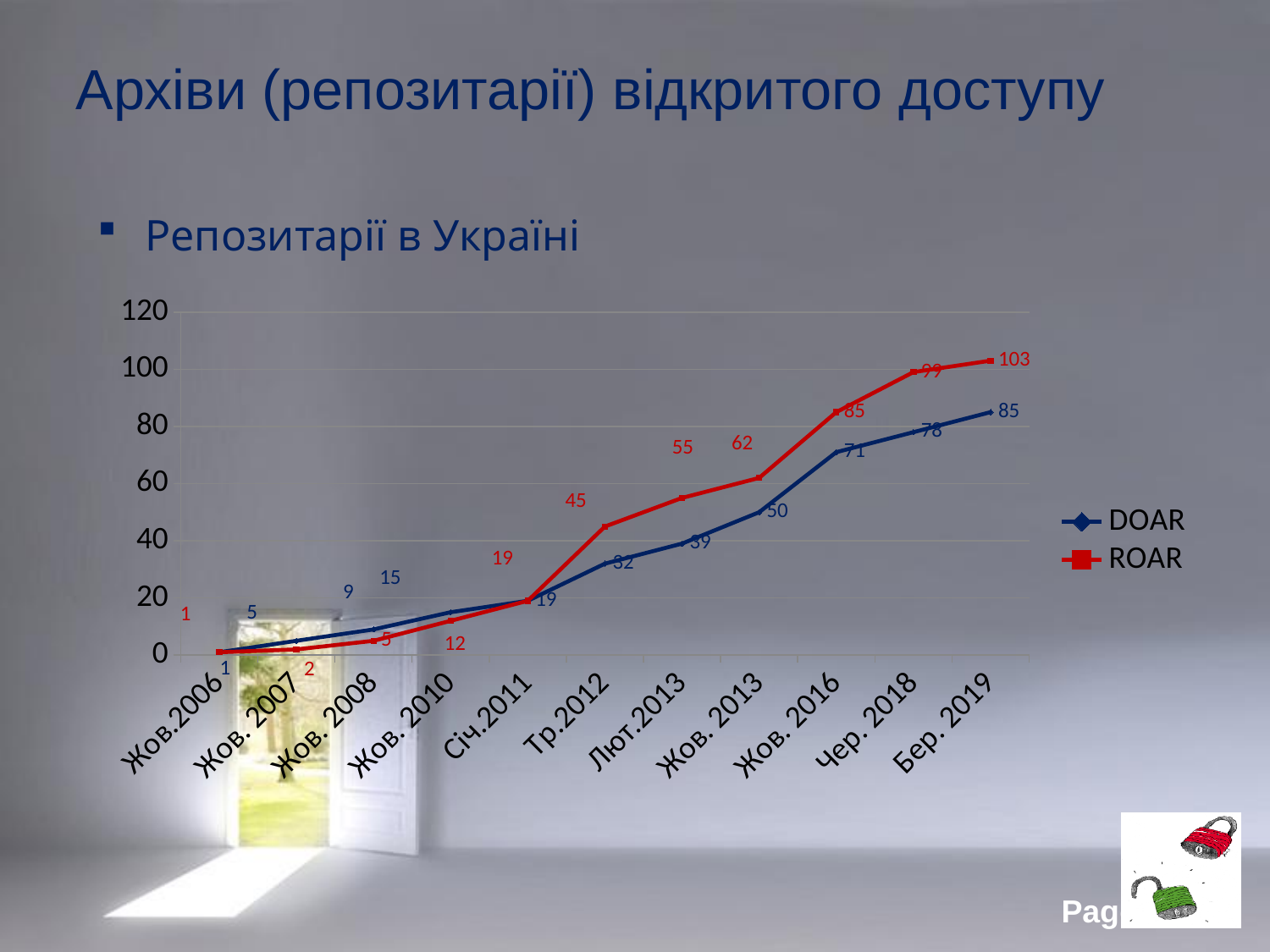
What is the DOAR value for Бер. 2019? 85 What is the DOAR value for Жов. 2013? 50 Which is larger for Жов. 2016, the DOAR value or the ROAR value? ROAR What is the ROAR value for Бер. 2019? 103 What is the ROAR value for Чер. 2018? 99 How many categories are shown on the x axis? 11 What is the difference between the ROAR and DOAR values for Бер. 2019? 18 Which category has the highest ROAR value? Бер. 2019 What is the difference between the DOAR values for Жов. 2016 and Жов. 2013? 21 What kind of chart is shown on the slide? Line chart What is the ROAR value for Тр.2012? 45 How many series does the legend list? 2